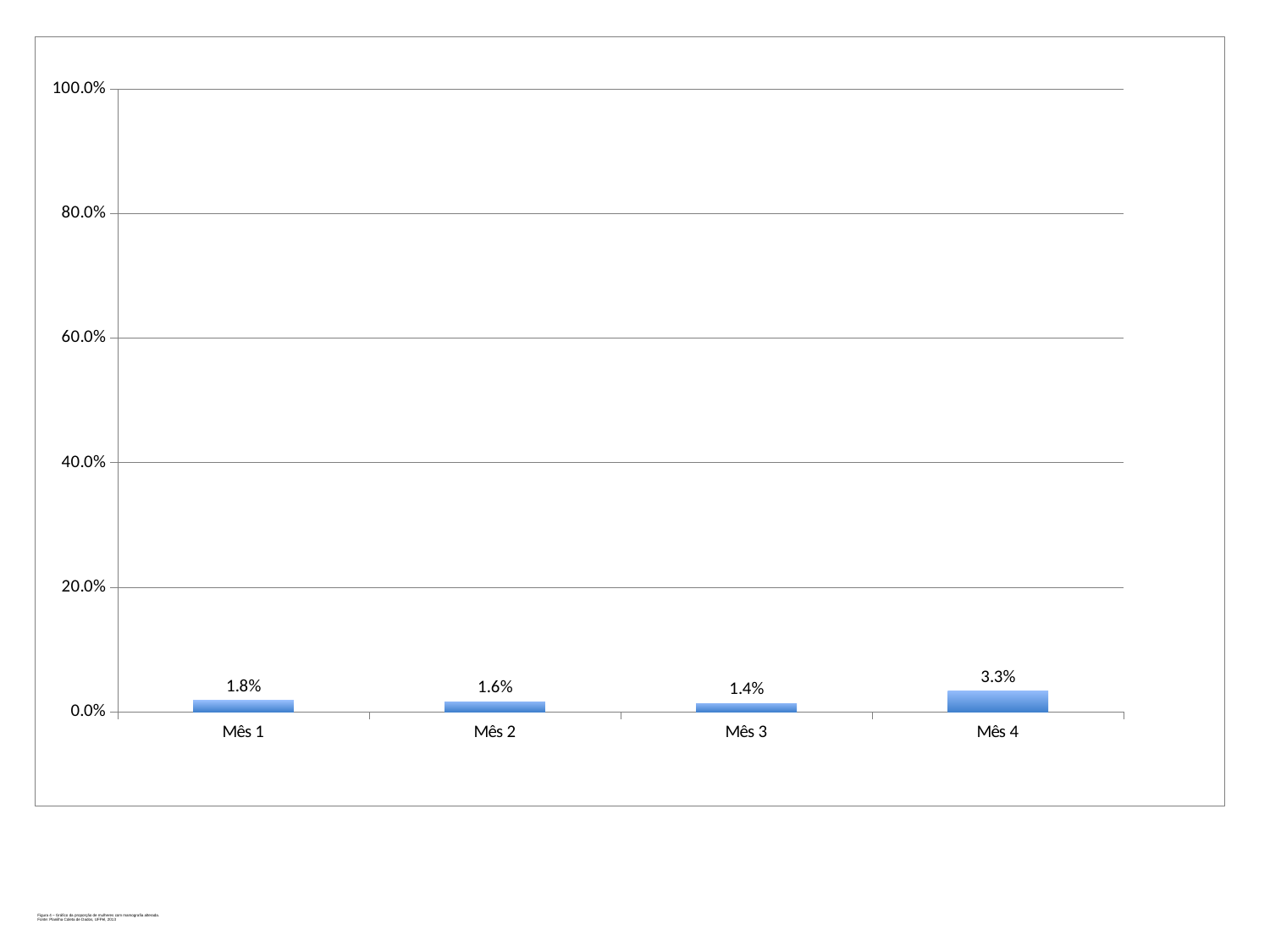
What is the difference between the values for Mês 1 and Mês 2? 0.2% Is the value for Mês 4 greater or less than 20.0%? less What is the value for Mês 1? 1.8% What is the difference between the values for Mês 4 and Mês 3? 1.9% What is the value for Mês 2? 1.6% What kind of chart is shown on the slide? bar chart How many categories are shown on the x axis? 4 Which month has the highest value? Mês 4 Which is larger, the value for Mês 1 or the value for Mês 4? Mês 4 Which month has the lowest value? Mês 3 What is the value for Mês 4? 3.3% What is the value for Mês 3? 1.4%